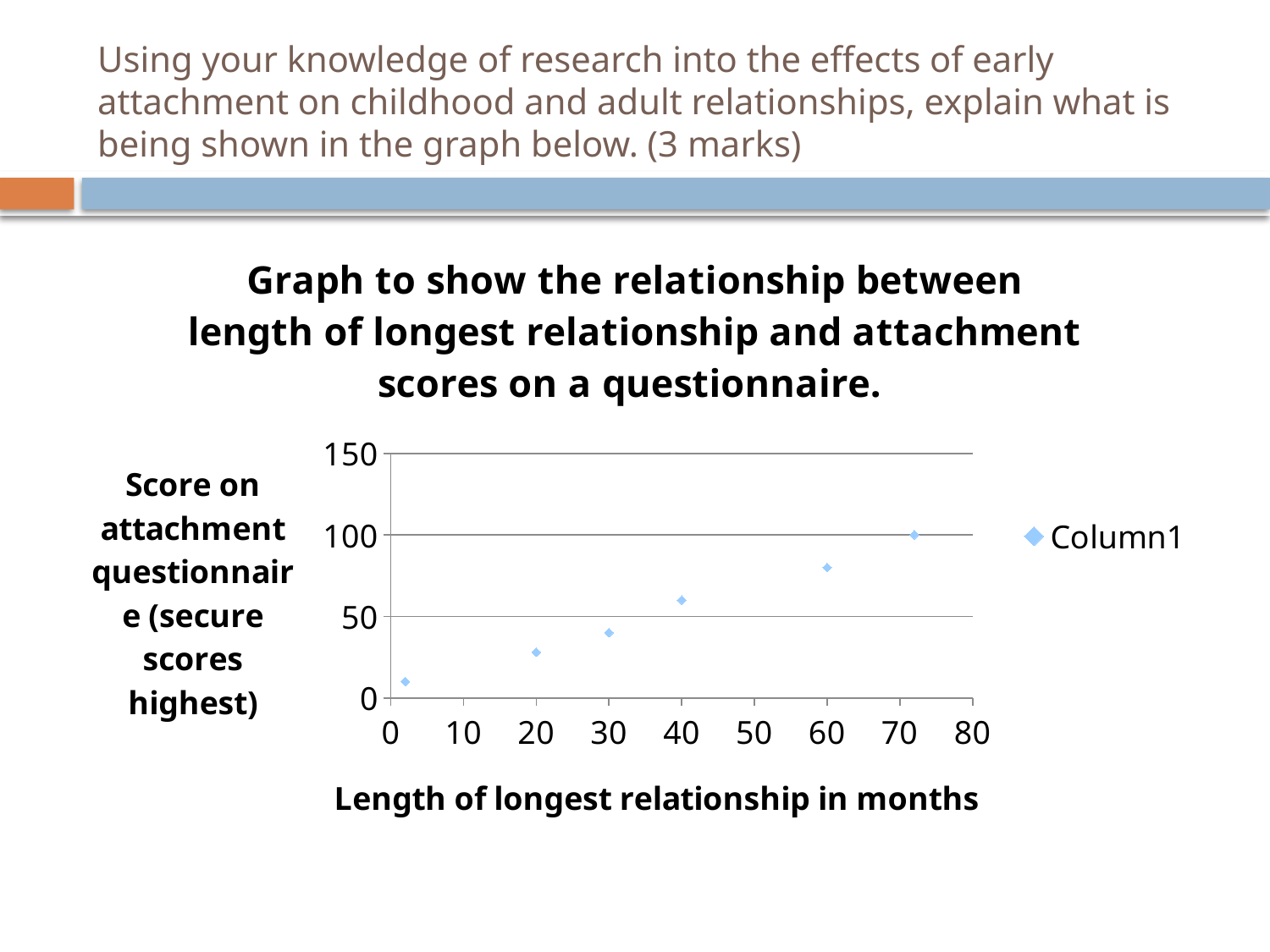
Is the score for the point closest to 0 months greater or less than 50? less Is the score for the point at about 60 months greater or less than 50? greater What is the name of the series shown in the legend? Column1 What kind of chart is shown on the slide? scatter chart Is the score for the point at about 30 months greater or less than 50? less How many series does the legend list? 1 What is the label of the x axis? Length of longest relationship in months How many data points are plotted on the chart? 6 Which point has the highest attachment score: the one with the shortest relationship length or the one with the longest? the one with the longest Do the attachment scores rise or fall as the length of the longest relationship increases? rise